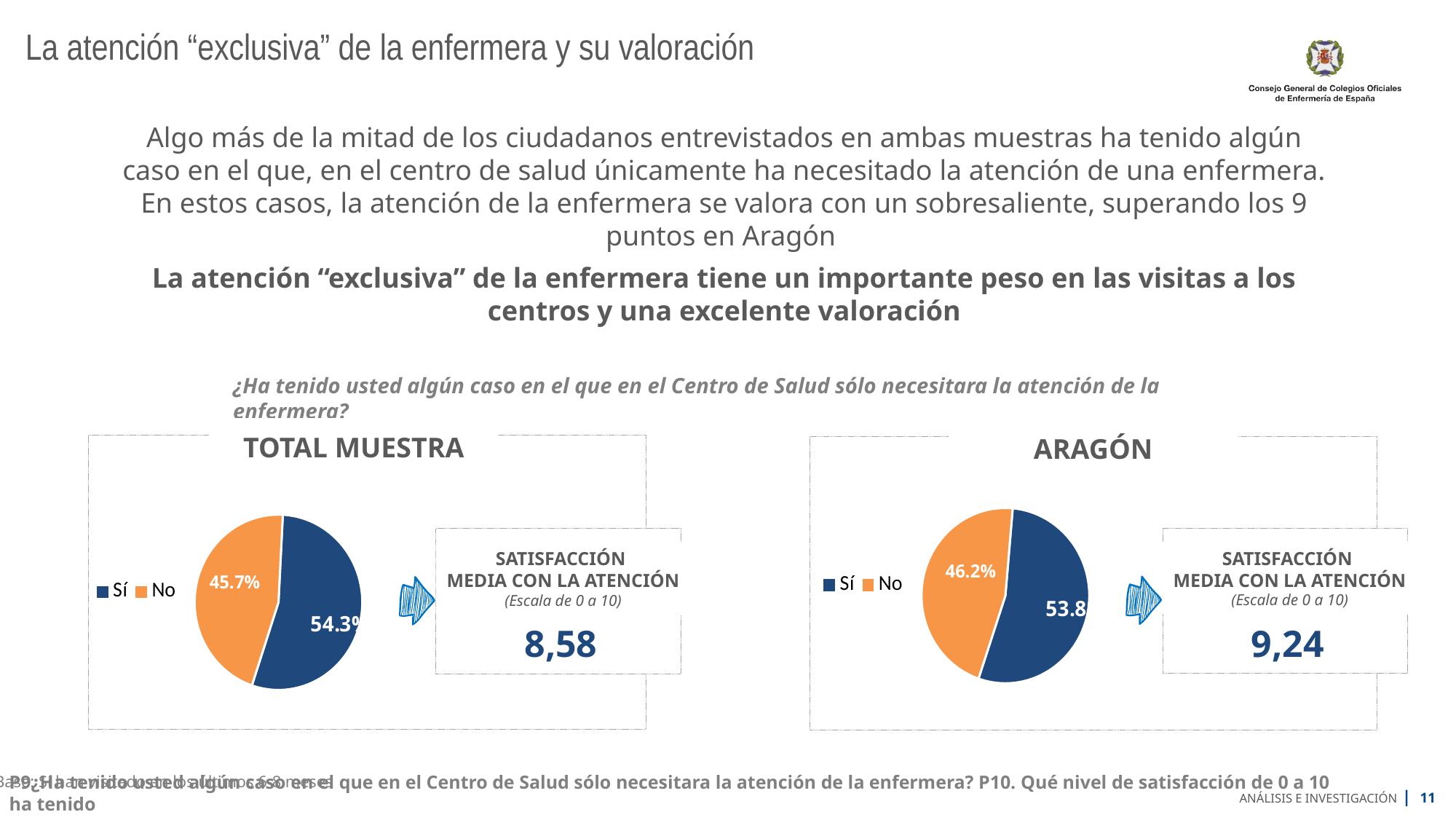
In the ARAGÓN pie chart, what colour is the Sí slice? Dark blue In the TOTAL MUESTRA pie chart, what is the difference in percentage points between Sí and No? 8.6 In the TOTAL MUESTRA pie chart, what percentage answered No? 45.7% What type of chart is used for TOTAL MUESTRA? Pie chart In the TOTAL MUESTRA pie chart, what percentage answered Sí? 54.3% In the ARAGÓN pie chart, what percentage answered No? 46.2% Is the No share larger in the TOTAL MUESTRA chart or in the ARAGÓN chart? ARAGÓN How many entries does the legend of the TOTAL MUESTRA chart list? 2 In the ARAGÓN pie chart, which response has the smaller share? No What is the title of the pie chart on the right side of the slide? ARAGÓN How many slices does the ARAGÓN pie chart have? 2 In the TOTAL MUESTRA pie chart, which response has the larger share? Sí